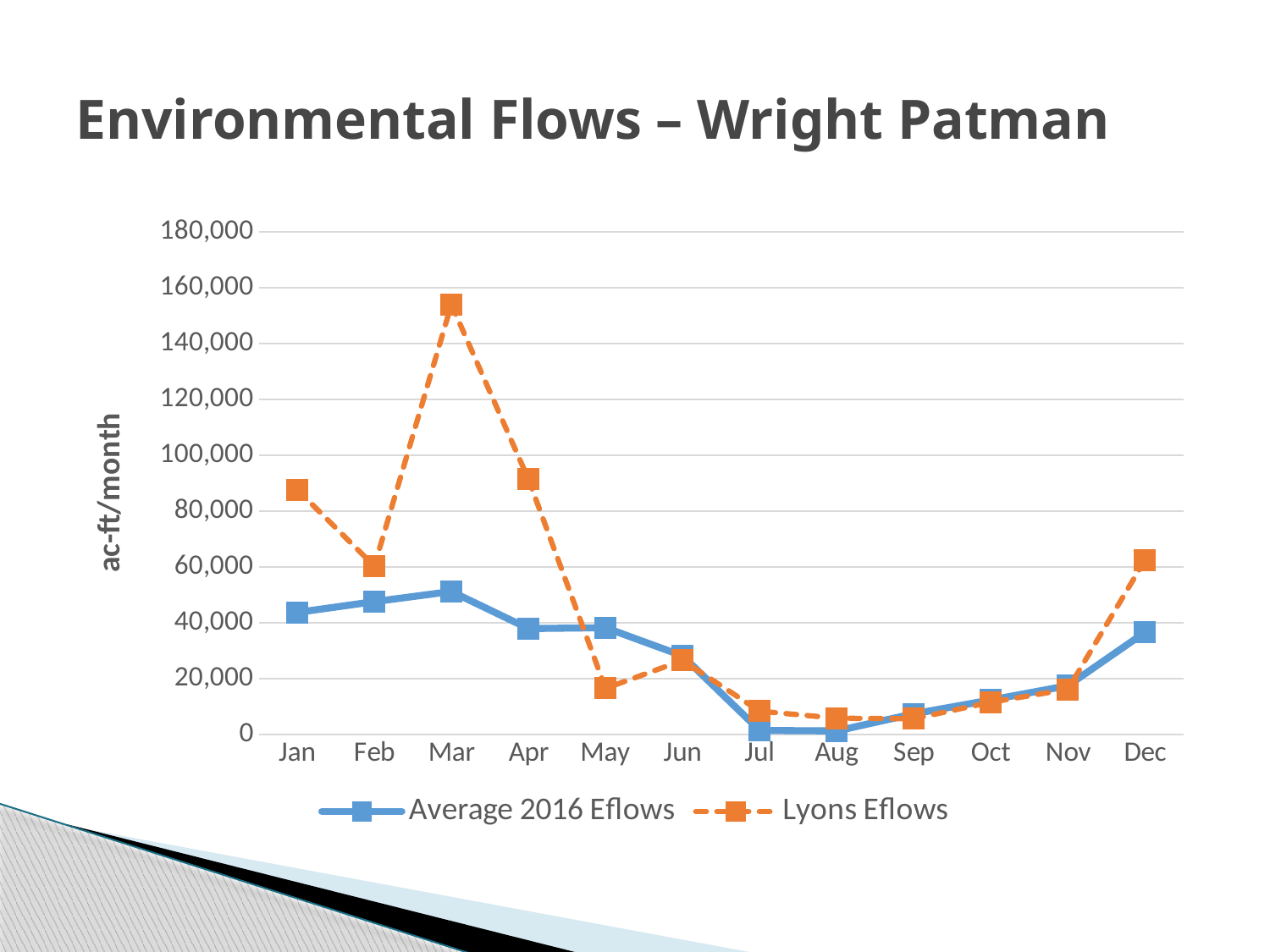
Is the Lyons Eflows value for Mar greater or less than 140,000? greater In which month is the Lyons Eflows value highest? Mar Is the Average 2016 Eflows value for Jul greater or less than 20,000? less How many series does the legend list? 2 How many months are plotted along the x axis? 12 What kind of chart is shown on the slide? line chart In which month is the Average 2016 Eflows value highest? Mar Does the Lyons Eflows line rise or fall from Mar to May? fall In Jan, which series has the larger value, Average 2016 Eflows or Lyons Eflows? Lyons Eflows Is the Lyons Eflows value for Dec greater or less than 50,000? greater In May, which series has the larger value, Average 2016 Eflows or Lyons Eflows? Average 2016 Eflows